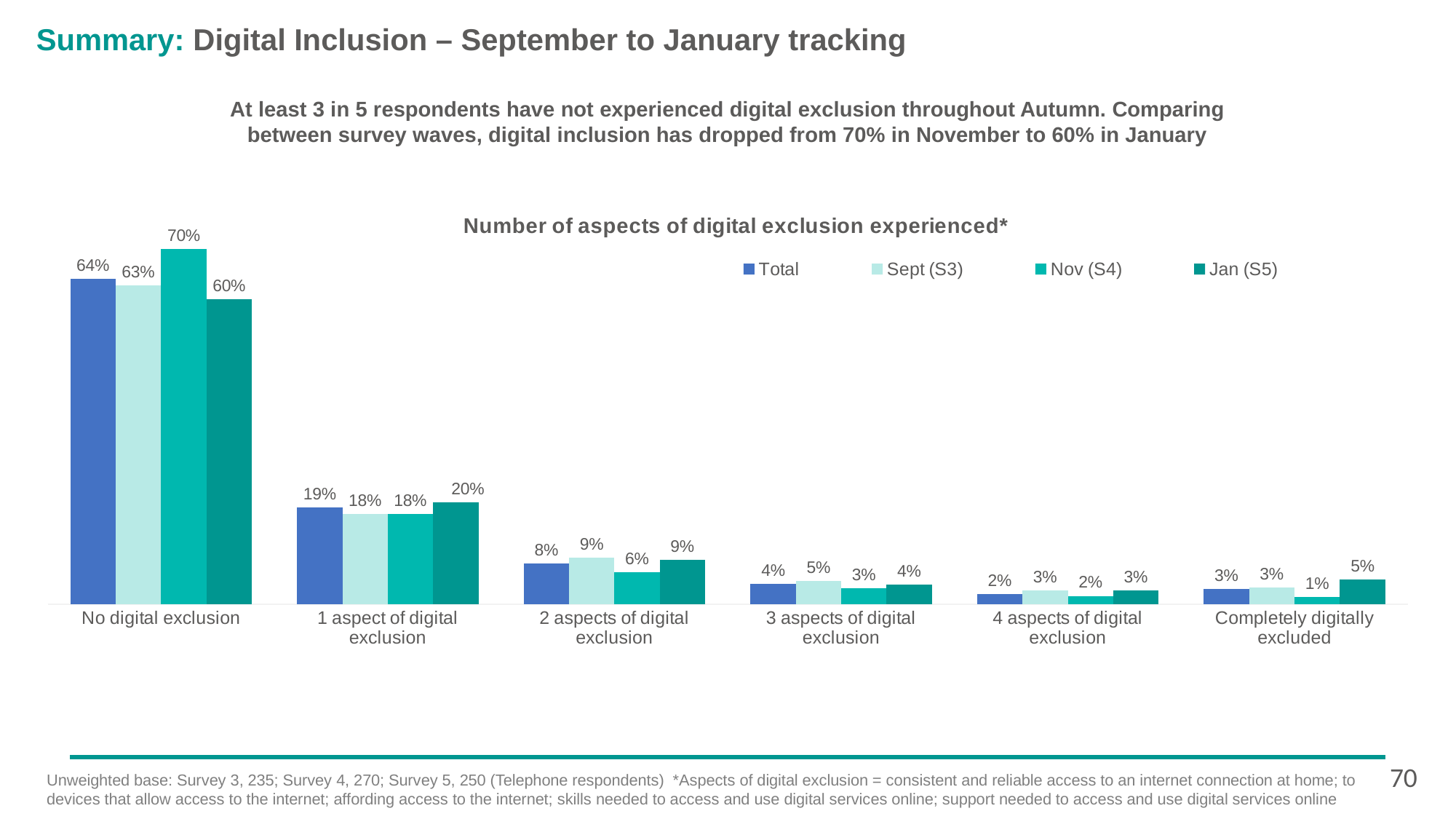
Which is larger for 3 aspects of digital exclusion: the Sept (S3) value or the Nov (S4) value? Sept (S3) Which category has the lowest Nov (S4) value? Completely digitally excluded How many series does the legend list? 4 What is the Nov (S4) value for No digital exclusion? 70% What is the title of the chart? Number of aspects of digital exclusion experienced* What is the Sept (S3) value for 2 aspects of digital exclusion? 9% What is the Total value for Completely digitally excluded? 3% How many categories are shown on the x axis? 6 What is the difference between the Nov (S4) and Jan (S5) values for No digital exclusion? 10% What kind of chart is shown on the slide? Bar chart What is the Jan (S5) value for 1 aspect of digital exclusion? 20% Which category has the highest Total value? No digital exclusion